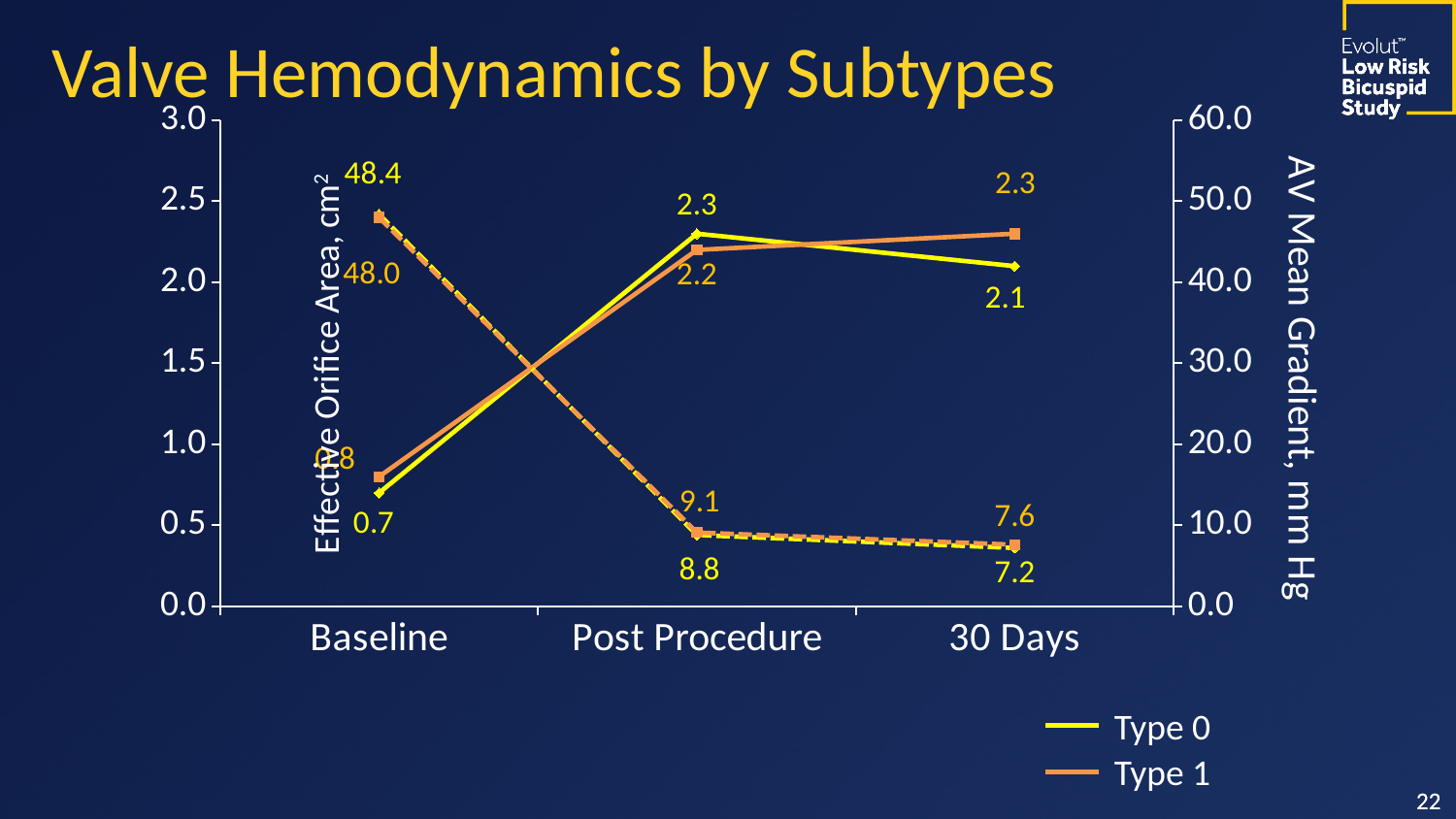
What is the difference between the AV Mean Gradient for Type 0 and Type 1 at Baseline? 0.4 How many series does the legend list? 2 What is the Effective Orifice Area for Type 1 at 30 Days? 2.3 At which time point is the Effective Orifice Area for Type 1 lowest? Baseline At which time point is the AV Mean Gradient for Type 0 highest? Baseline What is the AV Mean Gradient for Type 0 at Baseline? 48.4 What is the Effective Orifice Area for Type 0 at Baseline? 0.7 What type of chart is shown on the slide? Line chart How does the AV Mean Gradient for Type 1 change from Baseline to 30 Days? It falls What is the AV Mean Gradient for Type 1 at Post Procedure? 9.1 What is the AV Mean Gradient for Type 1 at 30 Days? 7.6 Which has the larger Effective Orifice Area at 30 Days, Type 0 or Type 1? Type 1